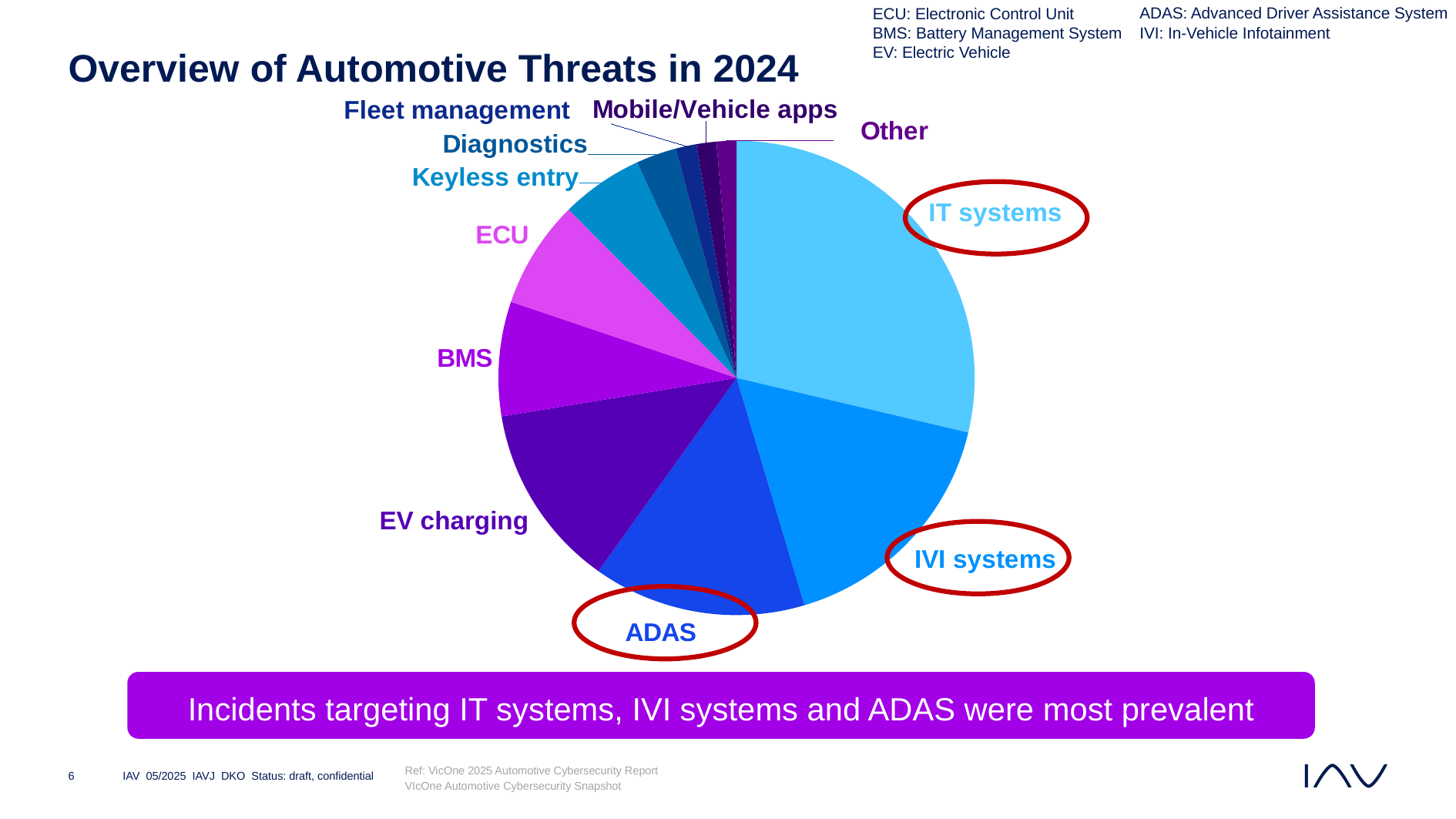
Which slice is larger, IT systems or ADAS? IT systems Which slice is larger, ECU or Diagnostics? ECU Which slice is larger, IVI systems or BMS? IVI systems Which category has the largest slice of the pie chart? IT systems Which three category labels on the pie chart are circled in red? IT systems, IVI systems and ADAS How many categories (slices) does the pie chart show? 11 What is the title of the slide containing the pie chart? Overview of Automotive Threats in 2024 What kind of chart is shown on the slide? Pie chart